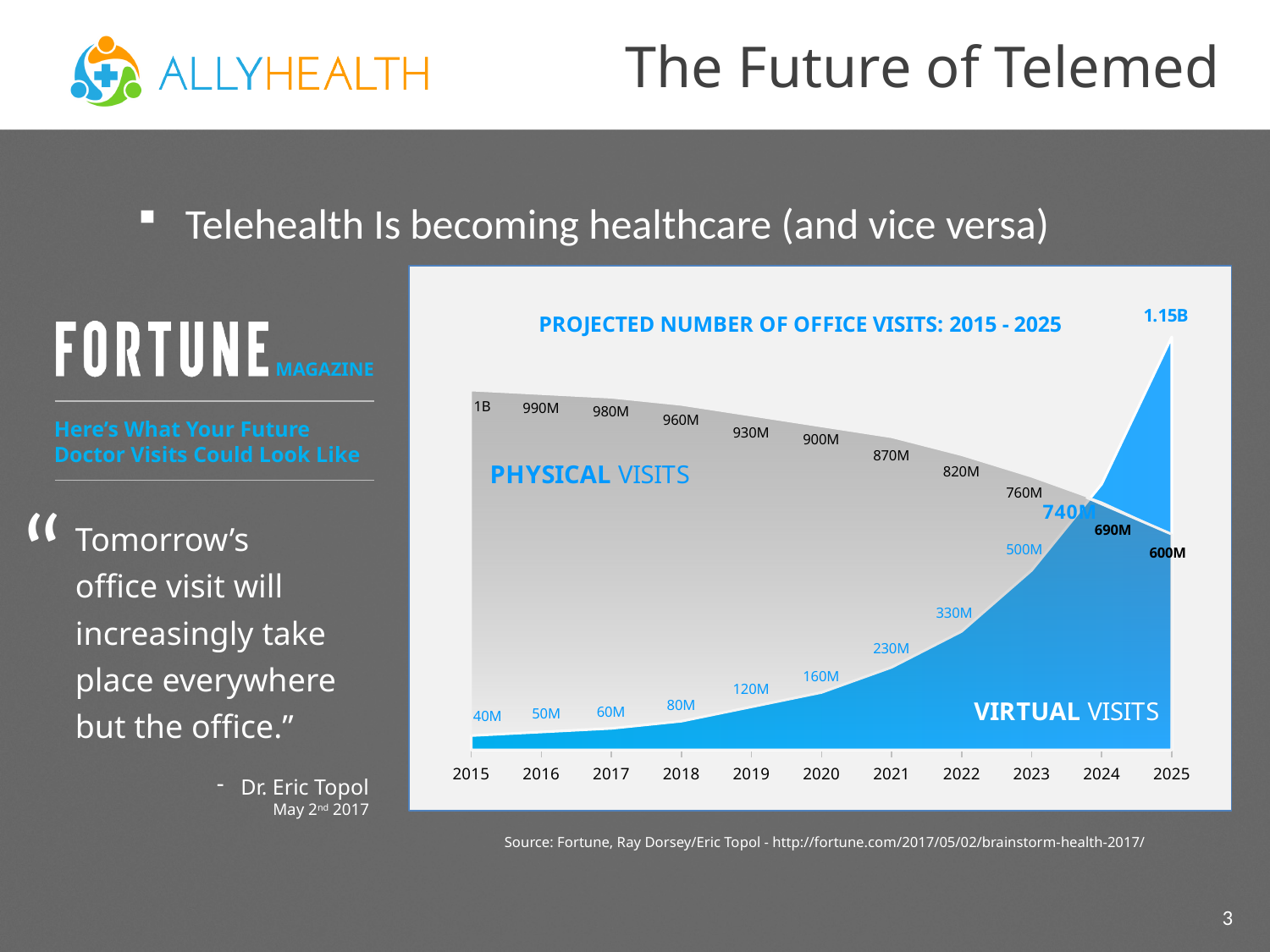
What kind of chart is shown on the slide? Area chart Do physical visits rise or fall from 2015 to 2025? Fall What is the title of the chart? PROJECTED NUMBER OF OFFICE VISITS: 2015 - 2025 What is the projected number of virtual visits in 2021? 230M What is the difference between physical visits and virtual visits in 2023? 260M What is the projected number of virtual visits in 2025? 1.15B Which is larger in 2024, physical visits or virtual visits? Virtual visits How many years are shown along the x axis of the chart? 11 What is the projected number of physical visits in 2015? 1B In which year are virtual visits projected to be lowest? 2015 In which year are physical visits projected to be lowest? 2025 What is the projected number of physical visits in 2022? 820M